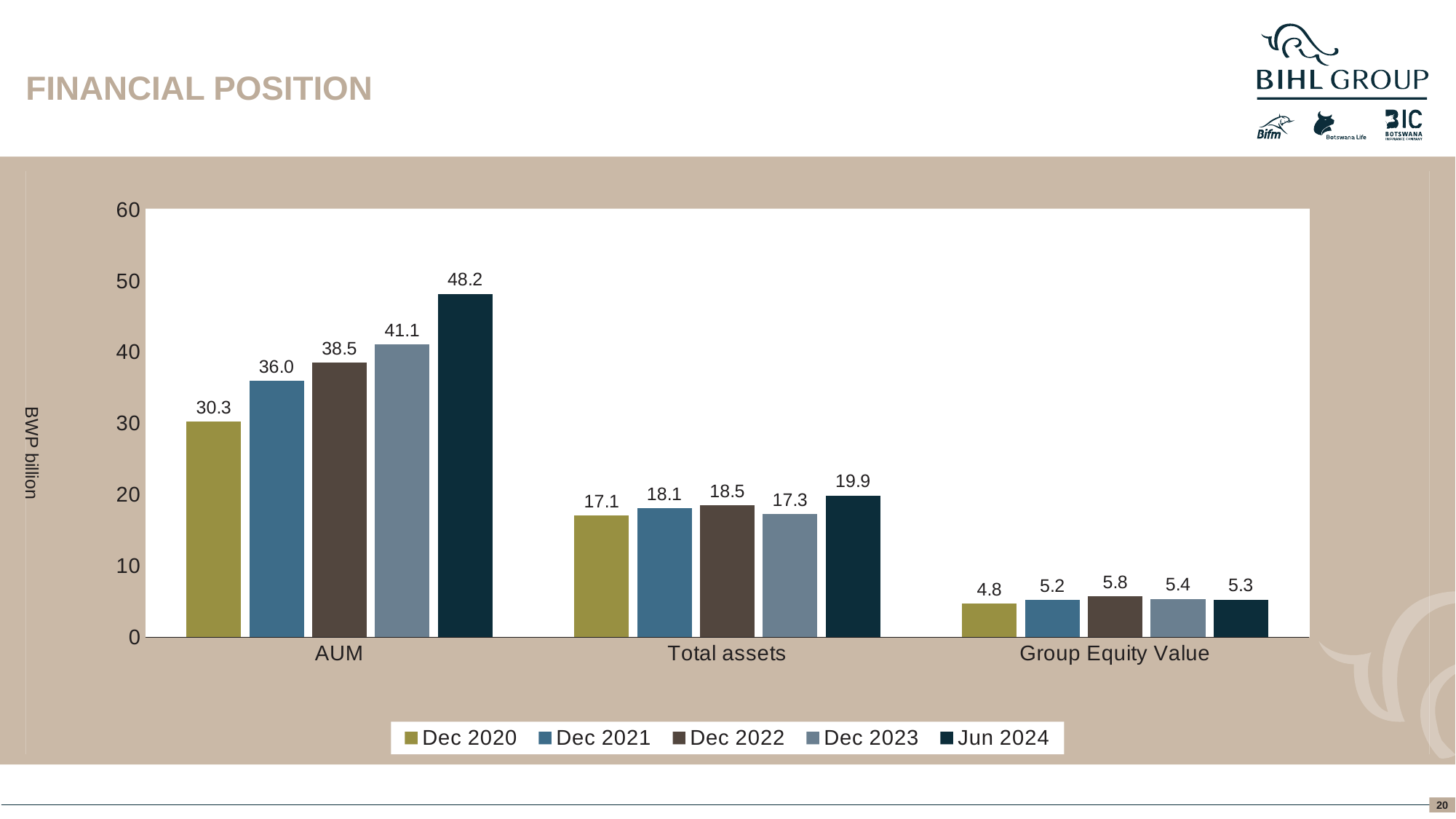
Do the AUM values rise or fall from Dec 2020 to Jun 2024? Rise What is the difference between the AUM for Jun 2024 and Dec 2020? 17.9 What is the Group Equity Value for Dec 2022? 5.8 Which period has the lowest Group Equity Value? Dec 2020 Which is larger: Total assets for Dec 2022 or Total assets for Dec 2023? Dec 2022 What is the AUM value for Jun 2024? 48.2 What is the Total assets value for Dec 2023? 17.3 How many categories are shown on the x axis? 3 How many series does the legend list? 5 What unit is shown on the y axis label? BWP billion Which period has the highest AUM? Jun 2024 What kind of chart is shown on the slide? Bar chart